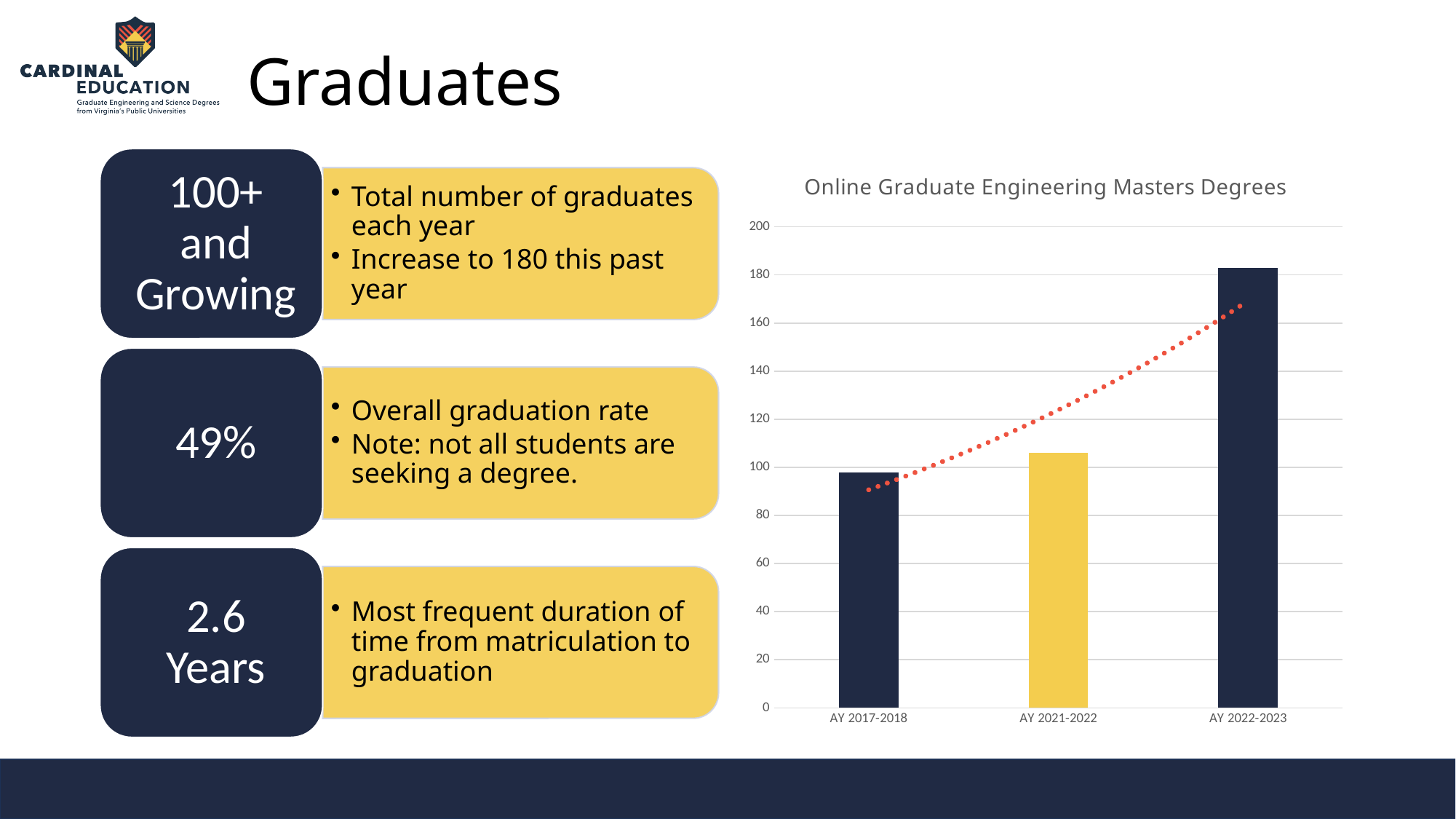
Is the value for AY 2022-2023 greater or less than 200? less What is the highest value shown on the chart's vertical axis? 200 Is the value for AY 2022-2023 greater or less than 160? greater Which is larger, the value for AY 2021-2022 or the value for AY 2022-2023? AY 2022-2023 Is the value for AY 2021-2022 greater or less than 100? greater How many academic years are plotted on the chart? 3 What is the title of the chart? Online Graduate Engineering Masters Degrees What kind of chart is shown on the slide? bar chart Do the values rise or fall from AY 2017-2018 to AY 2022-2023? rise Which academic year has the highest number of online graduate engineering masters degrees? AY 2022-2023 Which academic year has the lowest number of online graduate engineering masters degrees? AY 2017-2018